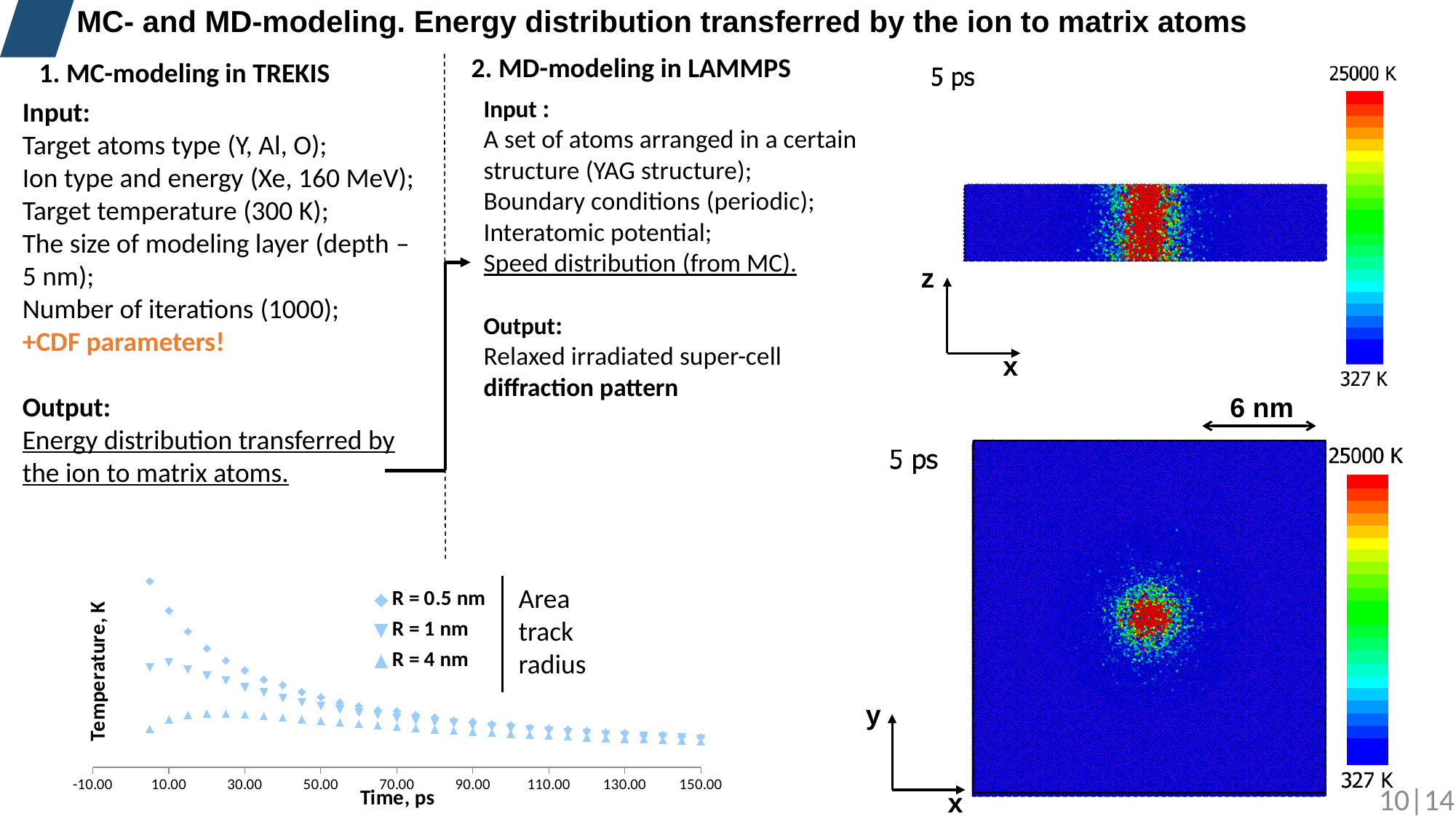
In the Temperature vs Time chart, does the temperature for R = 0.5 nm rise or fall as time increases? fall How many series does the legend of the Temperature vs Time chart list? 3 In the Temperature vs Time chart, which series has the lowest temperature at the earliest time point? R = 4 nm What kind of chart is shown at the bottom left of the slide (Temperature vs Time)? scatter chart In the Temperature vs Time chart, does the temperature for R = 1 nm rise or fall as time increases? fall In the Temperature vs Time chart, which series has the highest temperature at the earliest time point? R = 0.5 nm In the Temperature vs Time chart, at the earliest time point, which is higher: the temperature for R = 1 nm or for R = 4 nm? R = 1 nm What is the x-axis label of the Temperature vs Time chart? Time, ps In the Temperature vs Time chart, at the earliest time point, which is higher: the temperature for R = 0.5 nm or for R = 1 nm? R = 0.5 nm What are the legend entries of the Temperature vs Time chart? R = 0.5 nm, R = 1 nm, R = 4 nm In the Temperature vs Time chart, do the three series converge or diverge at later times? converge